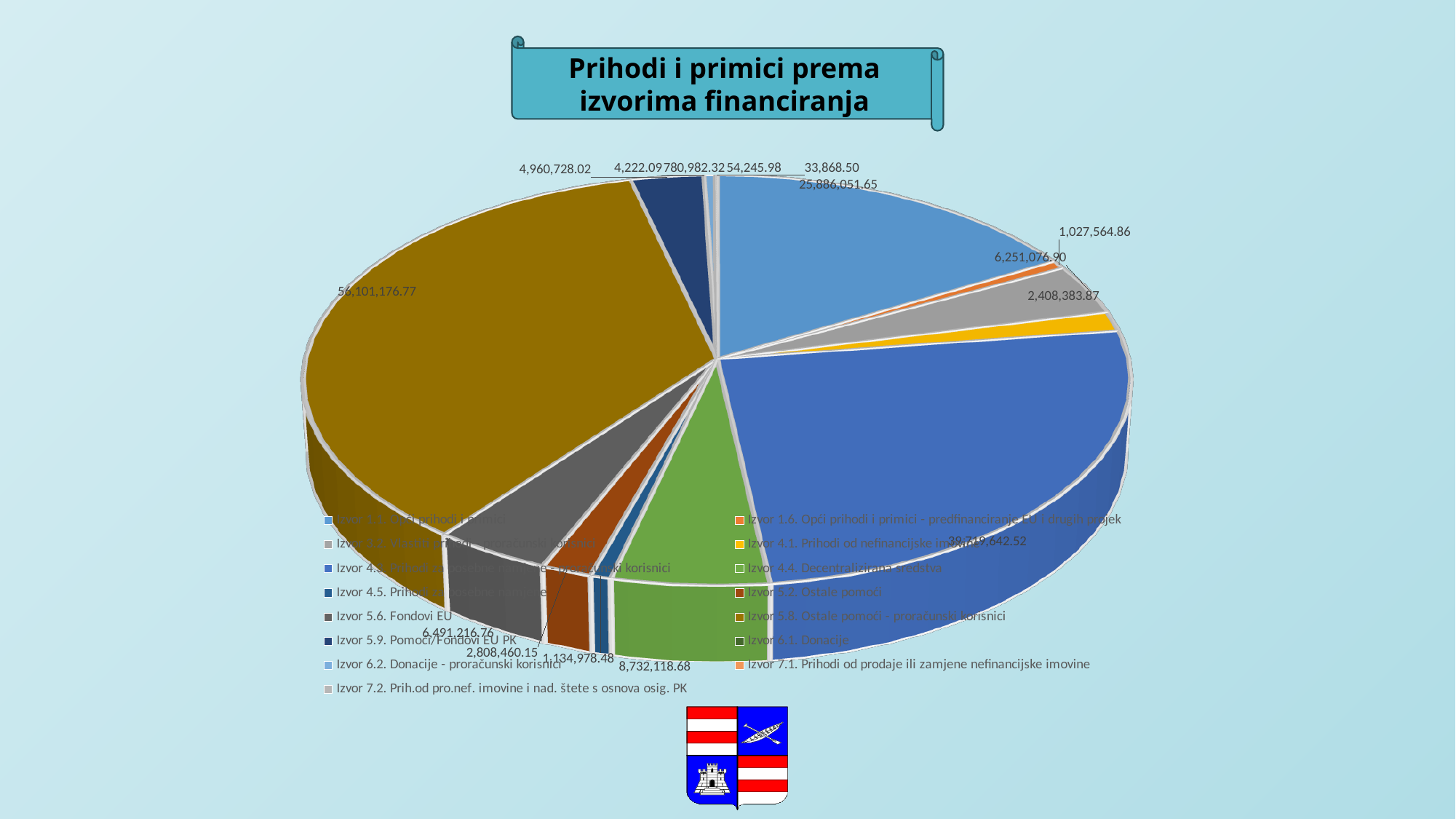
How many entries does the chart legend list? 15 What is the value shown for Izvor 5.8. Ostale pomoći - proračunski korisnici? 56,101,176.77 What is the value shown for Izvor 4.4. Decentralizirana sredstva (the green slice)? 8,732,118.68 What is the title of the chart? Prihodi i primici prema izvorima financiranja What colour is the largest slice of the pie? gold Which source has the largest slice of the pie? Izvor 5.8. Ostale pomoći - proračunski korisnici What is the value shown for Izvor 1.1. Opći prihodi i primici? 25,886,051.65 What type of chart is shown on the slide? pie chart Which is larger: the slice for Izvor 5.8. Ostale pomoći - proračunski korisnici or the slice for Izvor 1.1. Opći prihodi i primici? Izvor 5.8. Ostale pomoći - proračunski korisnici What is the difference between the value for Izvor 5.8. Ostale pomoći - proračunski korisnici (56,101,176.77) and the value for Izvor 1.1. Opći prihodi i primici (25,886,051.65)? 30,215,125.12 What is the largest value printed on the pie chart? 56,101,176.77 What is the smallest value printed on the pie chart? 4,222.09